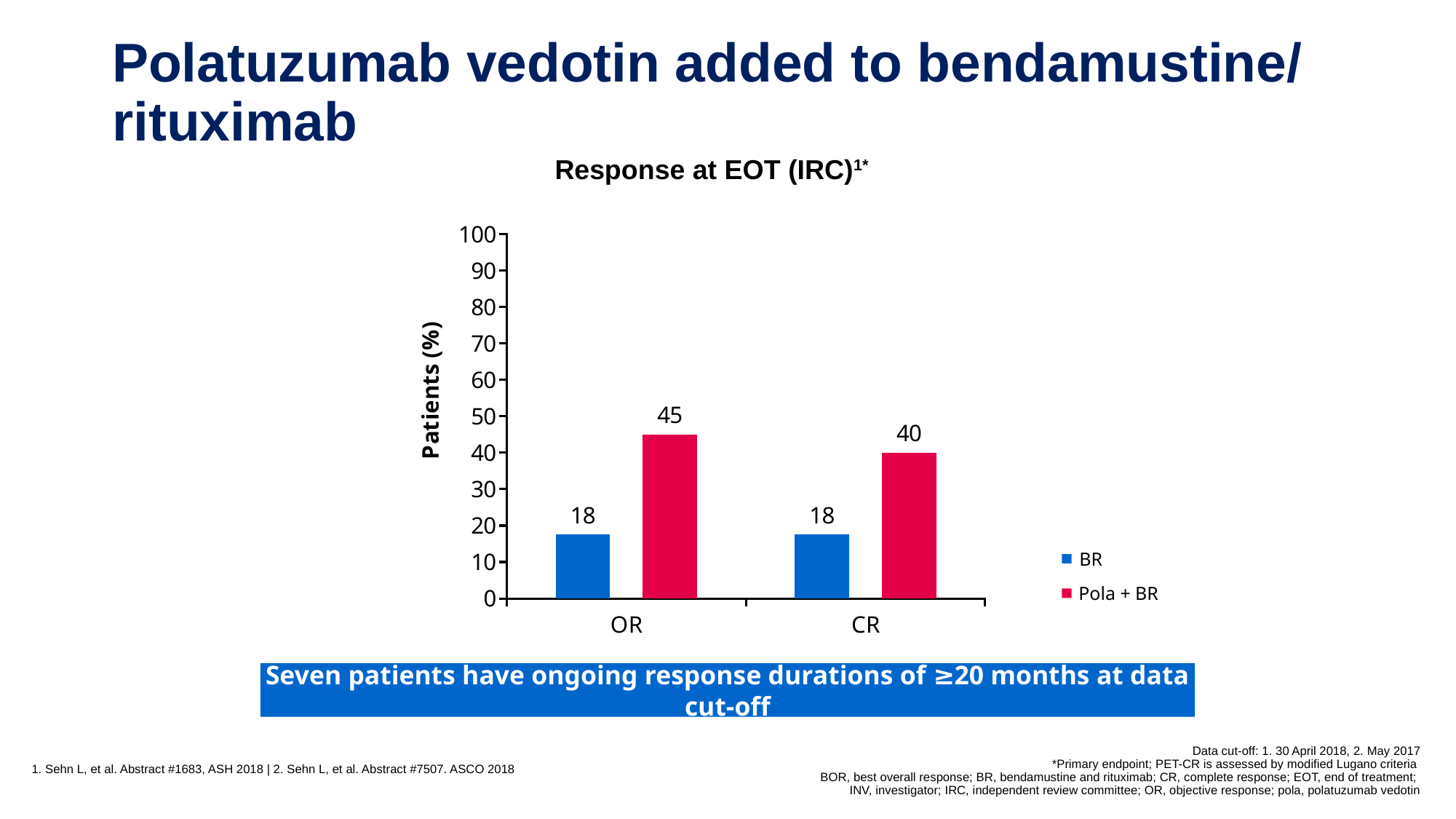
What is the label of the y axis? Patients (%) What kind of chart is shown on the slide? Bar chart Which is larger: the Pola + BR value for OR or the Pola + BR value for CR? Pola + BR value for OR What is the value for Pola + BR in the CR category? 40 Which series has the highest value in the OR category? Pola + BR Is the value for Pola + BR in the CR category greater or less than 50? less What is the value for Pola + BR in the OR category? 45 What is the value for BR in the CR category? 18 How many categories are shown on the x axis? 2 How many series does the legend list? 2 What is the difference between the Pola + BR and BR values in the OR category? 27 What is the difference between the Pola + BR and BR values in the CR category? 22